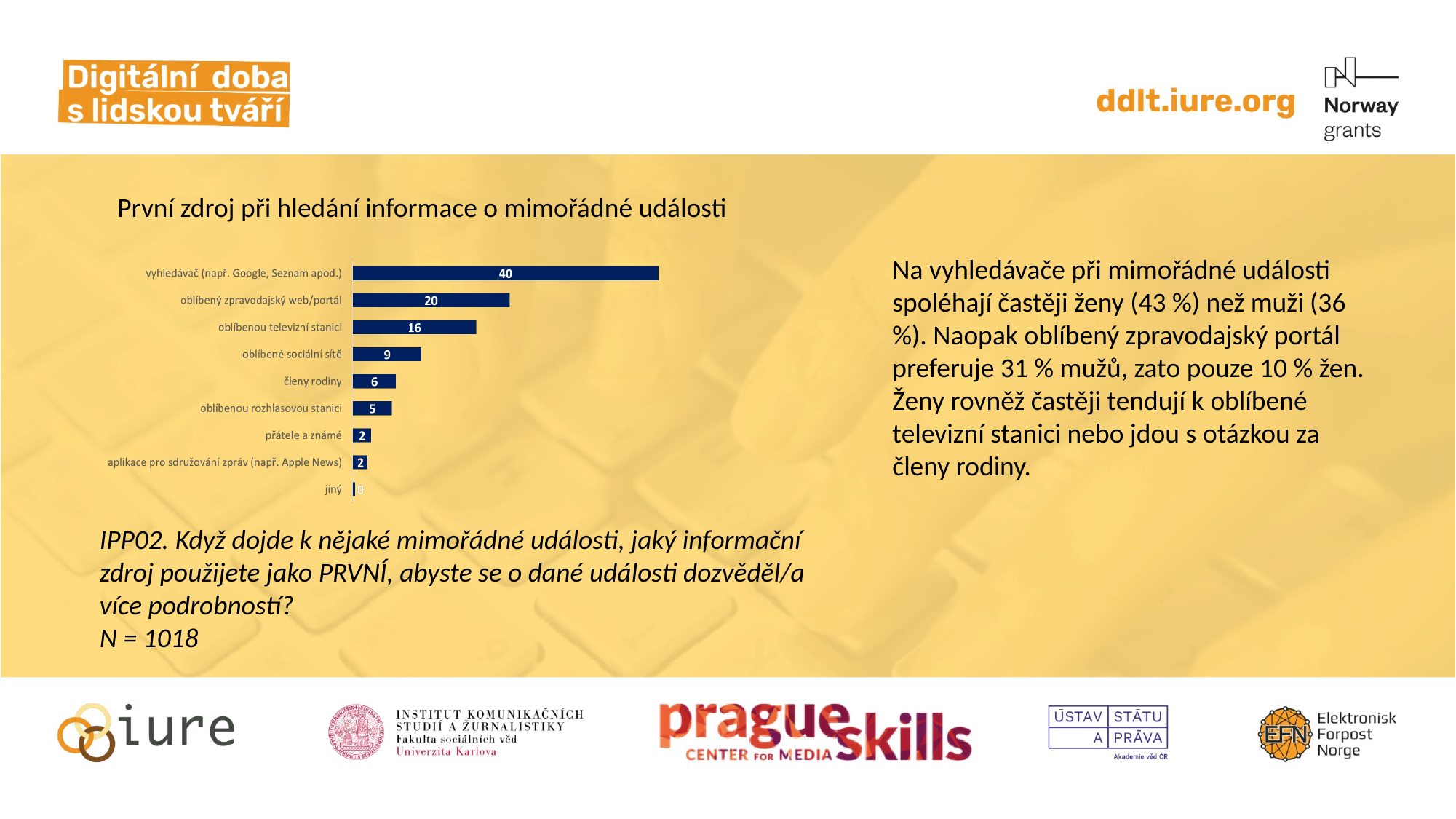
What is the value for 'vyhledávač (např. Google, Seznam apod.)'? 40 Which category has the highest value? vyhledávač (např. Google, Seznam apod.) What kind of chart is shown on the slide? bar chart What is the difference between the values for 'oblíbenou televizní stanici' and 'oblíbené sociální sítě'? 7 What is the title of the chart? První zdroj při hledání informace o mimořádné události How many categories are shown in the chart? 9 What is the value for 'členy rodiny'? 6 What is the value for 'oblíbený zpravodajský web/portál'? 20 What is the value for 'oblíbenou televizní stanici'? 16 Which is larger: the value for 'oblíbené sociální sítě' or the value for 'oblíbenou rozhlasovou stanici'? oblíbené sociální sítě What is the difference between the values for 'vyhledávač (např. Google, Seznam apod.)' and 'oblíbený zpravodajský web/portál'? 20 Which category has the lowest value? jiný